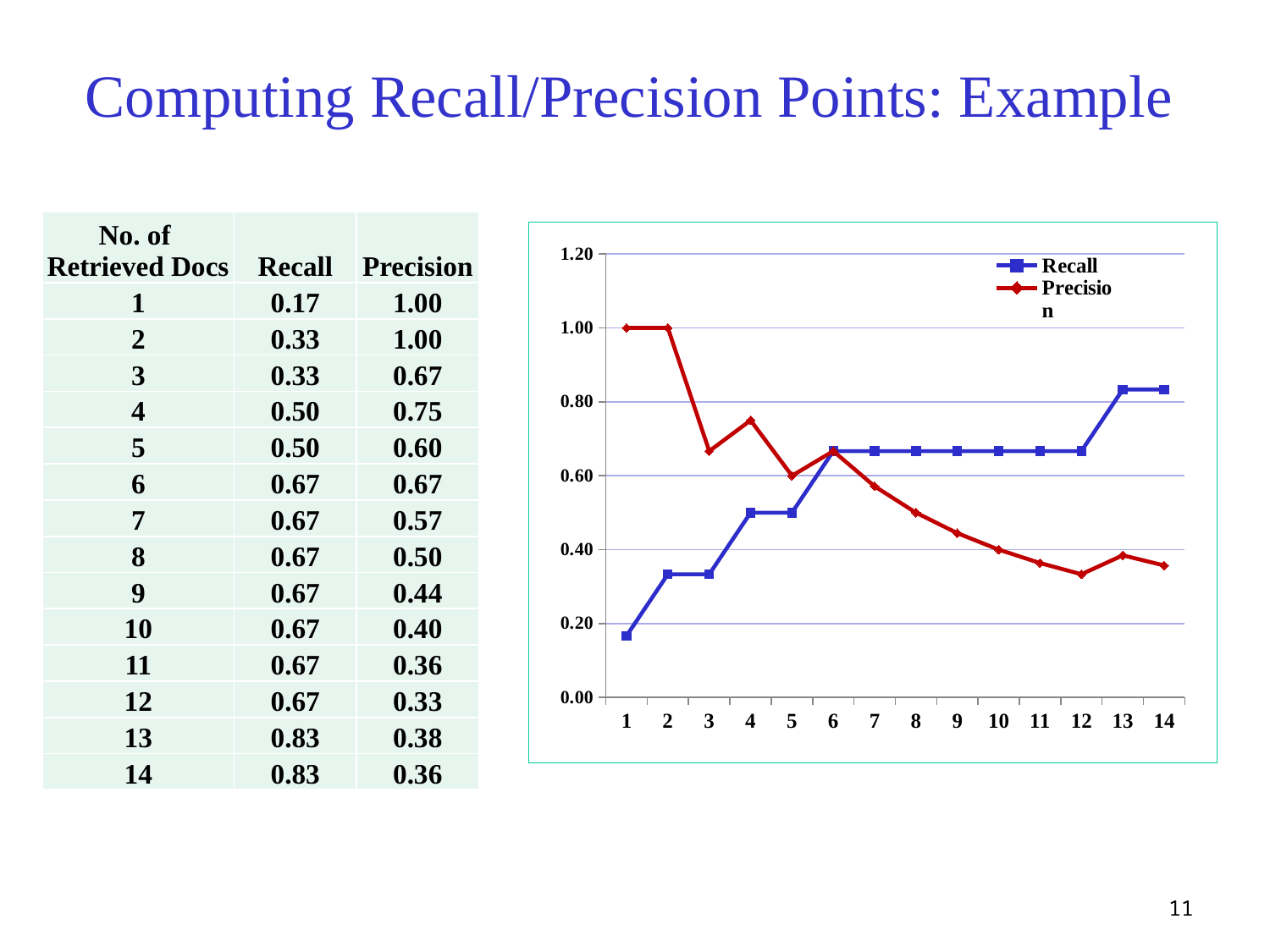
How many series does the chart legend list? 2 What is the Precision value at 12 retrieved documents? 0.33 What is the Precision value at 1 retrieved document? 1.00 Does the Recall line generally rise or fall as the number of retrieved documents increases? rise What is the difference between Precision and Recall at 1 retrieved document? 0.83 What kind of chart is shown on the slide? line chart How many points along the x axis does each line in the chart have? 14 Which is larger at 4 retrieved documents, Recall or Precision? Precision What is the Recall value at 14 retrieved documents? 0.83 Does the Precision line generally rise or fall as the number of retrieved documents increases? fall At which number of retrieved documents is Precision lowest? 12 Is the Recall value at 13 retrieved documents greater or less than 0.80? greater